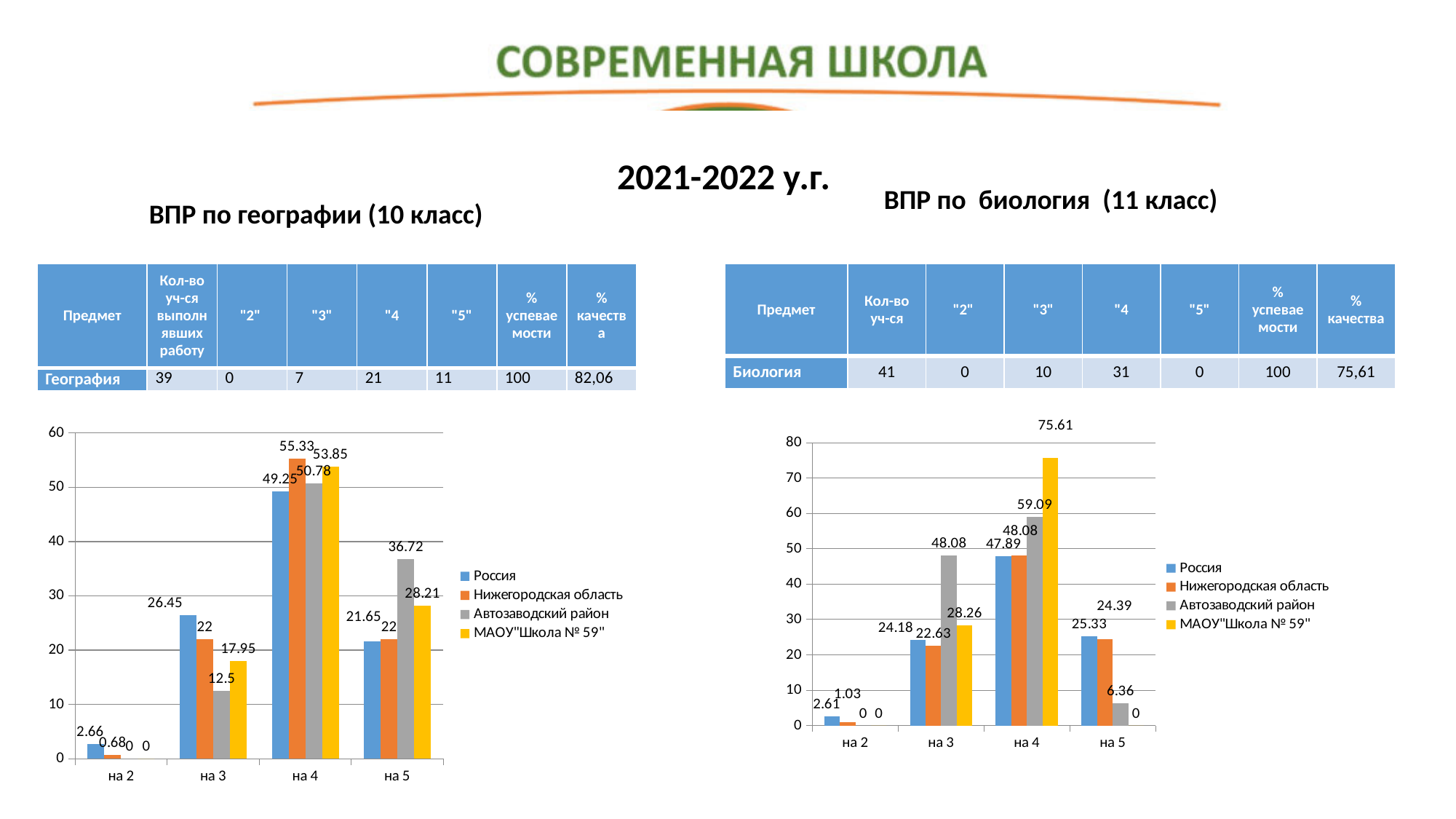
In the right chart (ВПР по биология, 11 класс), is the value for Россия at "на 3" larger or smaller than the value for Автозаводский район at "на 3"? Smaller In the left chart (ВПР по географии, 10 класс), what is the difference between the МАОУ"Школа № 59" value at "на 4" and at "на 5"? 25.64 In the right chart (ВПР по биология, 11 класс), what is the value for Автозаводский район at "на 3"? 48.08 What kind of chart is the left chart (ВПР по географии, 10 класс)? Bar chart In the right chart (ВПР по биология, 11 класс), what colour represents МАОУ"Школа № 59"? Yellow In the left chart (ВПР по географии, 10 класс), which series has the highest value at "на 4"? Нижегородская область In the left chart (ВПР по географии, 10 класс), what is the value for Автозаводский район at "на 5"? 36.72 In the left chart (ВПР по географии, 10 класс), what is the value for Россия at "на 4"? 49.25 In the left chart (ВПР по географии, 10 класс), how many series does the legend list? 4 In the right chart (ВПР по биология, 11 класс), which series has the lowest value at "на 5"? МАОУ"Школа № 59" In the right chart (ВПР по биология, 11 класс), what is the value for МАОУ"Школа № 59" at "на 4"? 75.61 In the right chart (ВПР по биология, 11 класс), how many categories are shown on the x axis? 4